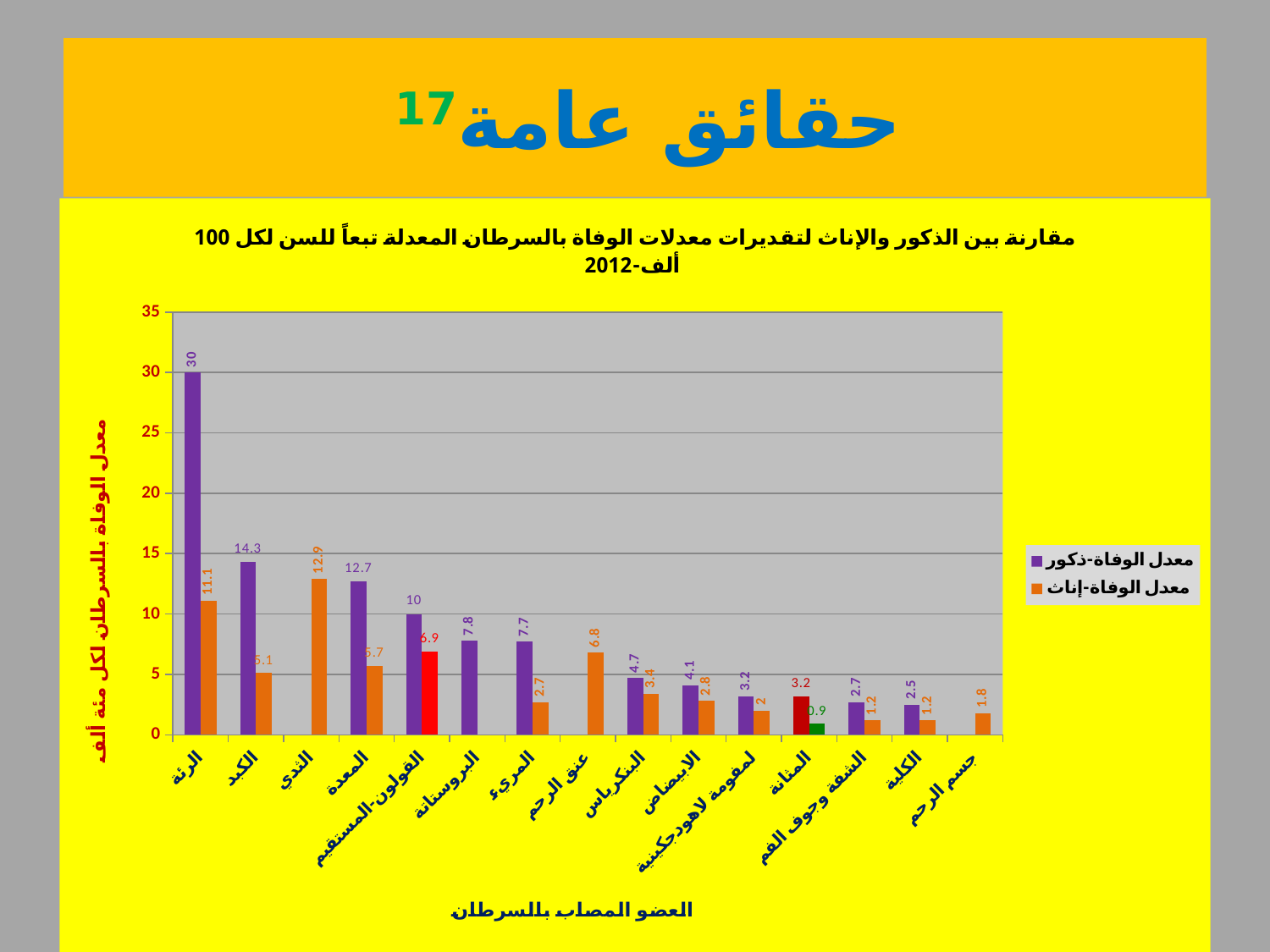
Which is larger for المعدة (stomach): the male death rate or the female death rate? the male death rate Which organ has the highest male death rate? الرئة Which organ has the lowest female death rate among those with a female bar? المثانة What is the female death rate for القولون-المستقيم (colorectal)? 6.9 How many series does the legend list? 2 What is the male death rate (معدل الوفاة-ذكور) for الرئة (lung)? 30 What kind of chart is shown on the slide? bar chart How many organ categories are shown on the x axis? 15 Is the male death rate for الكبد (liver) greater or less than 10? greater What is the difference between the male and female death rates for الرئة (lung)? 18.9 What is the female death rate for الكبد (liver)? 5.1 What is the female death rate (معدل الوفاة-إناث) for الثدي (breast)? 12.9